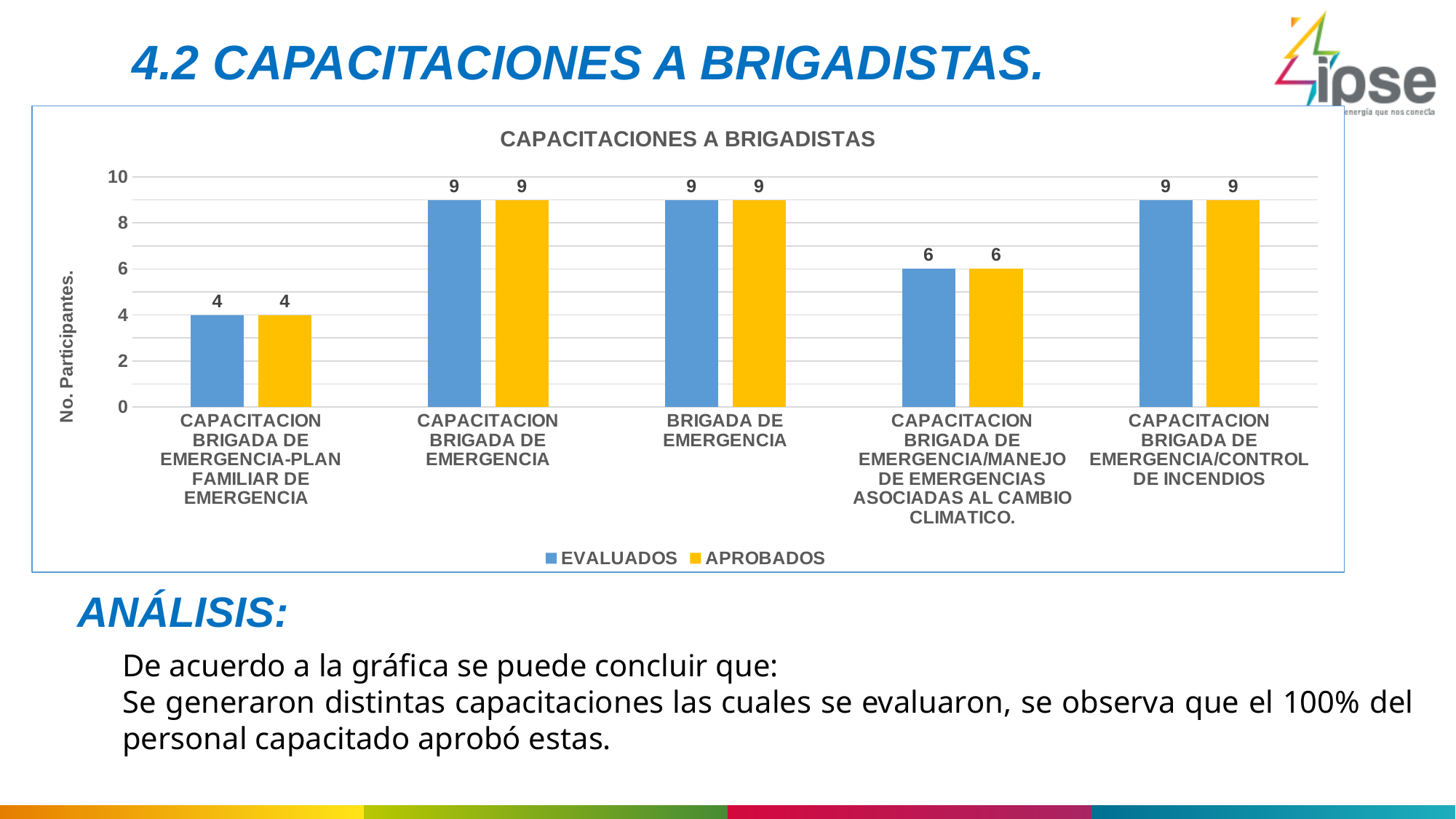
What kind of chart is shown on the slide? bar chart Which is larger: the APROBADOS value for CAPACITACION BRIGADA DE EMERGENCIA/CONTROL DE INCENDIOS or the APROBADOS value for CAPACITACION BRIGADA DE EMERGENCIA/MANEJO DE EMERGENCIAS ASOCIADAS AL CAMBIO CLIMATICO.? CAPACITACION BRIGADA DE EMERGENCIA/CONTROL DE INCENDIOS What is the APROBADOS value for CAPACITACION BRIGADA DE EMERGENCIA-PLAN FAMILIAR DE EMERGENCIA? 4 Is the EVALUADOS value for CAPACITACION BRIGADA DE EMERGENCIA/MANEJO DE EMERGENCIAS ASOCIADAS AL CAMBIO CLIMATICO. greater or less than 8? less How many categories are shown on the x axis of the chart? 5 What is the EVALUADOS value for CAPACITACION BRIGADA DE EMERGENCIA/MANEJO DE EMERGENCIAS ASOCIADAS AL CAMBIO CLIMATICO.? 6 What is the label of the vertical axis of the chart? No. Participantes. What is the title of the chart? CAPACITACIONES A BRIGADISTAS What is the EVALUADOS value for BRIGADA DE EMERGENCIA? 9 How many series does the legend list? 2 Which category has the lowest EVALUADOS value? CAPACITACION BRIGADA DE EMERGENCIA-PLAN FAMILIAR DE EMERGENCIA What is the difference between the EVALUADOS value for CAPACITACION BRIGADA DE EMERGENCIA and the EVALUADOS value for CAPACITACION BRIGADA DE EMERGENCIA-PLAN FAMILIAR DE EMERGENCIA? 5